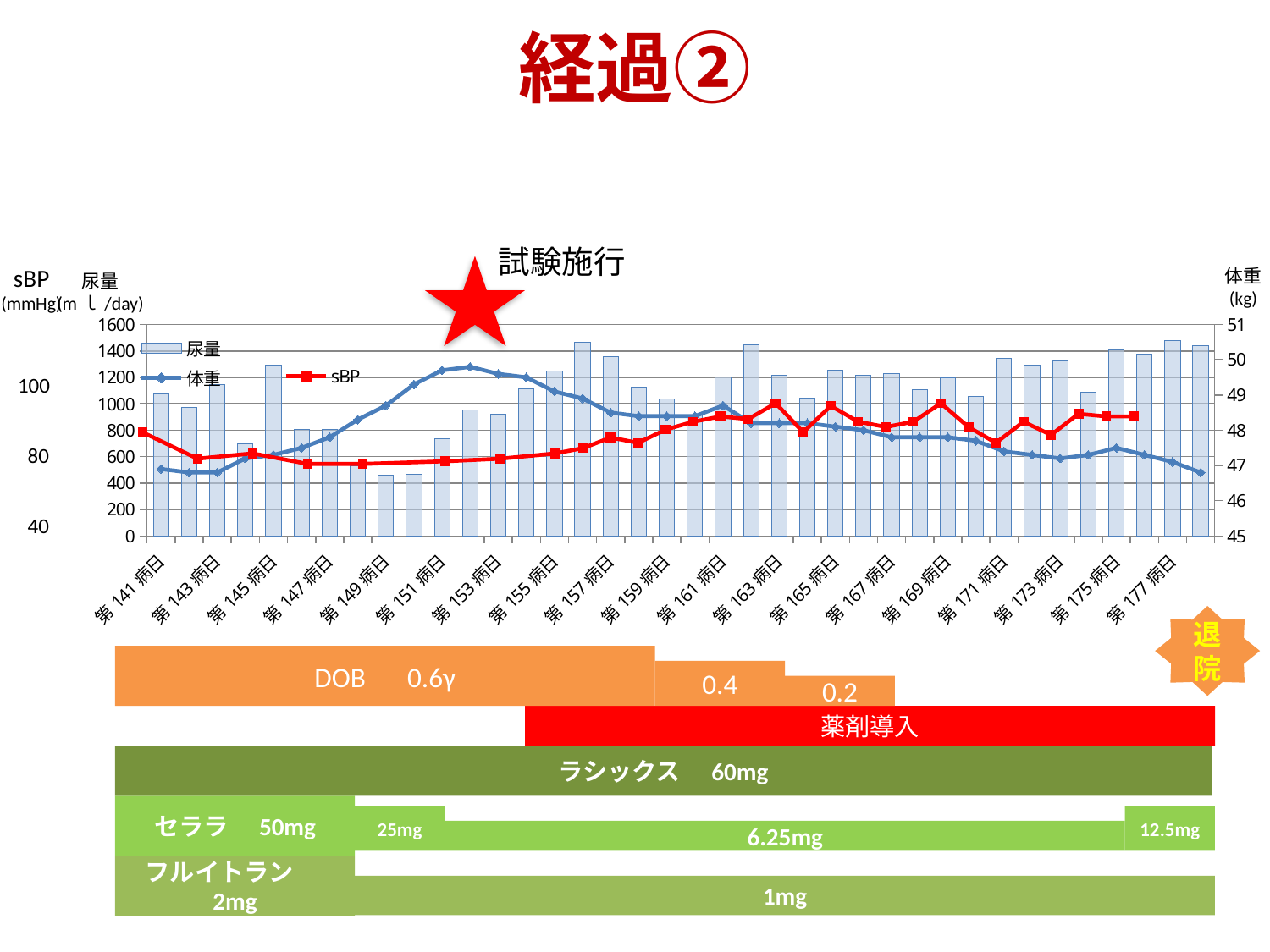
Which series in the chart is drawn as bars? 尿量 Is the 尿量 bar for 第149病日 greater or less than 600? less What kind of chart is shown on the slide? Combined bar and line chart Is the 体重 value for 第153病日 greater or less than 49 kg? greater What is the title of the slide containing the chart? 経過② On which day does the 体重 line reach its highest point? 第152病日 How many series does the chart legend list? 3 Is the 尿量 bar for 第151病日 greater or less than 1000? less Does the 体重 line rise or fall between 第153病日 and 第177病日? fall